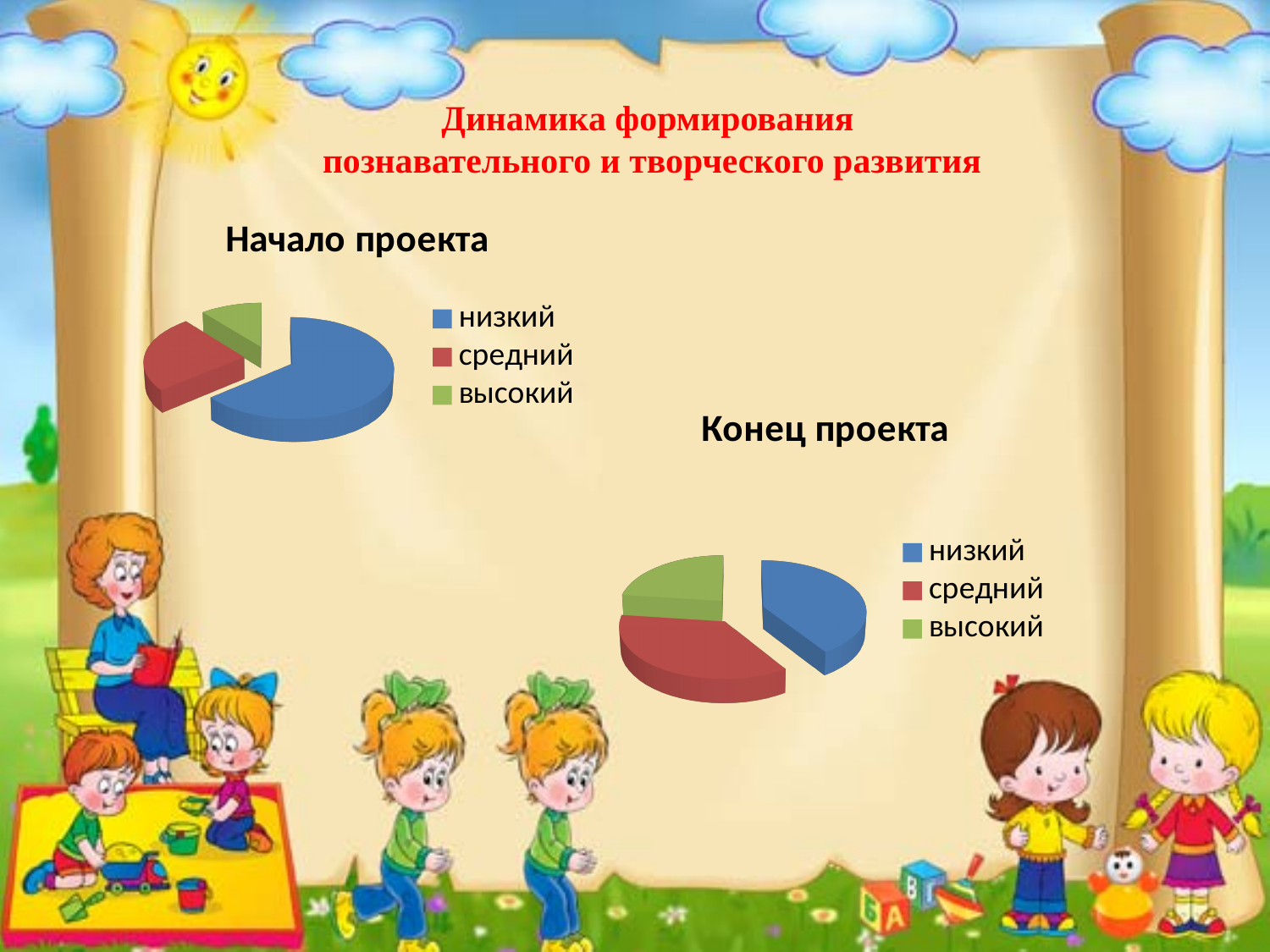
What kind of chart is the "Начало проекта" chart? pie chart In the "Начало проекта" chart, which slice is larger: низкий or средний? низкий In the "Начало проекта" chart, which category has the smallest slice? высокий In the "Начало проекта" chart, which slice is larger: средний or высокий? средний In the "Начало проекта" chart, which category has the largest slice? низкий How many entries does the legend of the "Конец проекта" chart list? 3 What kind of chart is the "Конец проекта" chart? pie chart In the "Конец проекта" chart, which category has the largest slice? низкий In the "Конец проекта" chart, which slice is larger: средний or низкий? низкий What is the title of the chart positioned in the lower right of the slide? Конец проекта How many slices does the "Начало проекта" pie chart have? 3 What colour represents the category "высокий" in the charts? green